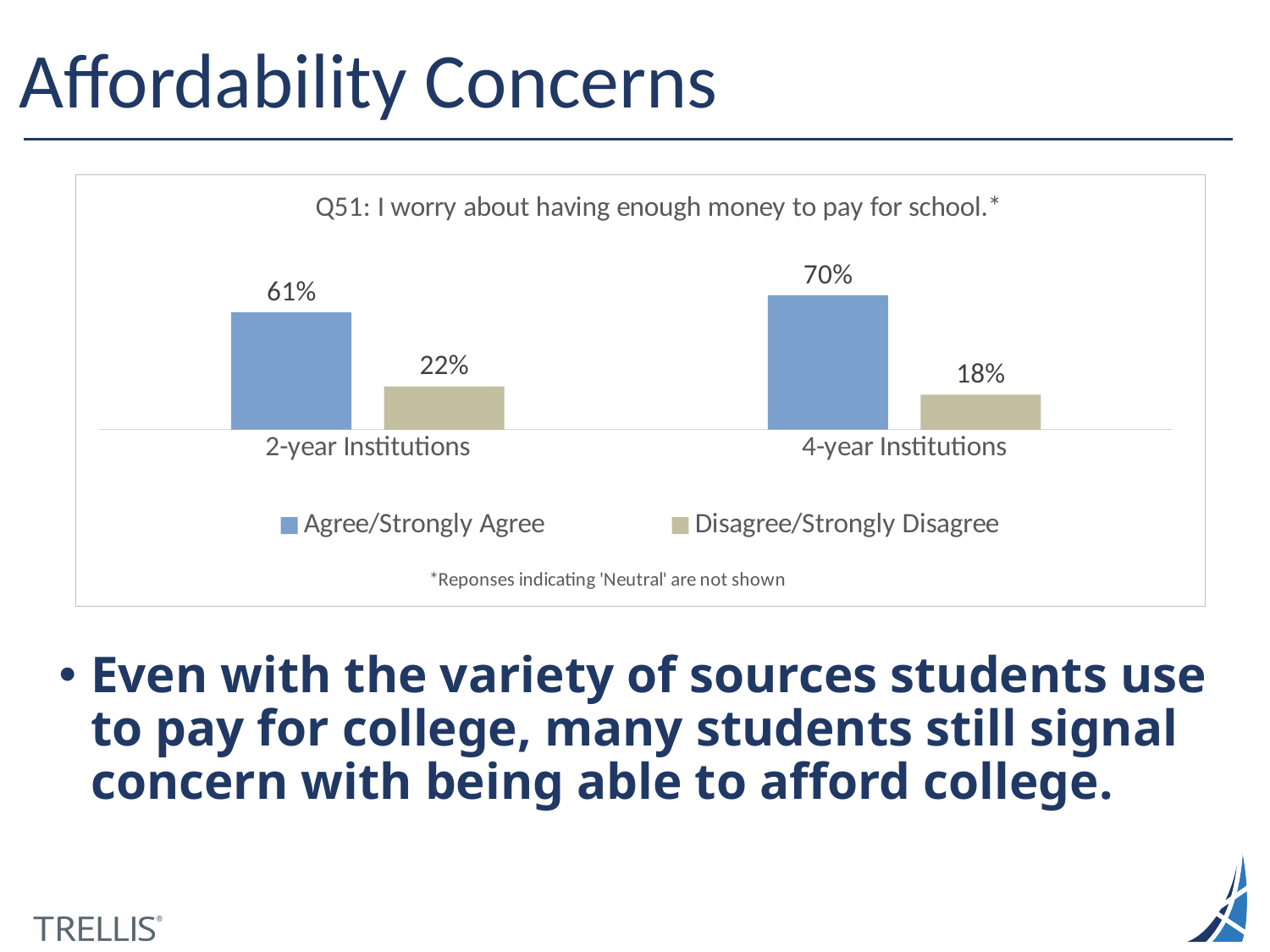
What is the Disagree/Strongly Disagree value for 4-year institutions? 18% How many series does the legend list? 2 What percentage of students at 4-year institutions Agree/Strongly Agree with the statement? 70% What is the Disagree/Strongly Disagree value for 2-year institutions? 22% What is the difference between the Agree/Strongly Agree percentages for 4-year and 2-year institutions? 9% Is the Disagree/Strongly Disagree value larger for 2-year or 4-year institutions? 2-year Institutions How many institution categories are shown on the x axis? 2 What is the difference between the Agree/Strongly Agree and Disagree/Strongly Disagree values for 2-year institutions? 39% What percentage of students at 2-year institutions Agree/Strongly Agree that they worry about having enough money to pay for school? 61% Which institution type has the lower Disagree/Strongly Disagree percentage? 4-year Institutions Which institution type has the higher Agree/Strongly Agree percentage? 4-year Institutions What kind of chart is shown on the slide? Bar chart